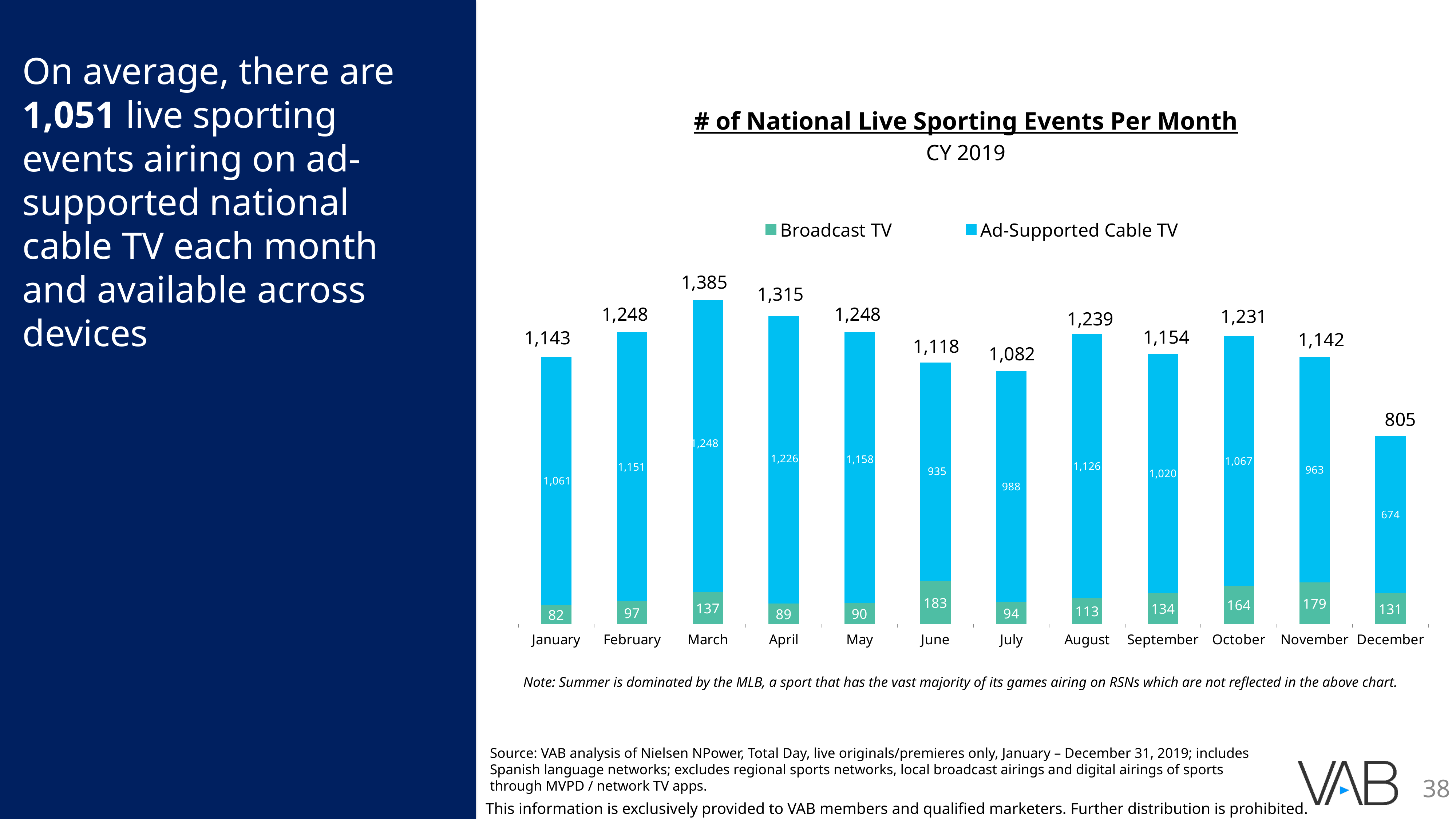
What is the total number of national live sporting events in December? 805 What type of chart is shown on the slide? Stacked bar chart What is the Ad-Supported Cable TV value for March? 1,248 What is the difference between the Ad-Supported Cable TV values for April and July? 238 What is the subtitle shown under the chart title? CY 2019 How many months are shown on the x axis? 12 Which month has the lowest Ad-Supported Cable TV value? December Which month has the highest total number of national live sporting events? March Which is larger, the Broadcast TV value for October or the Broadcast TV value for November? November How many series does the legend list? 2 What is the difference between the total for March and the total for December? 580 What is the Broadcast TV value for June? 183